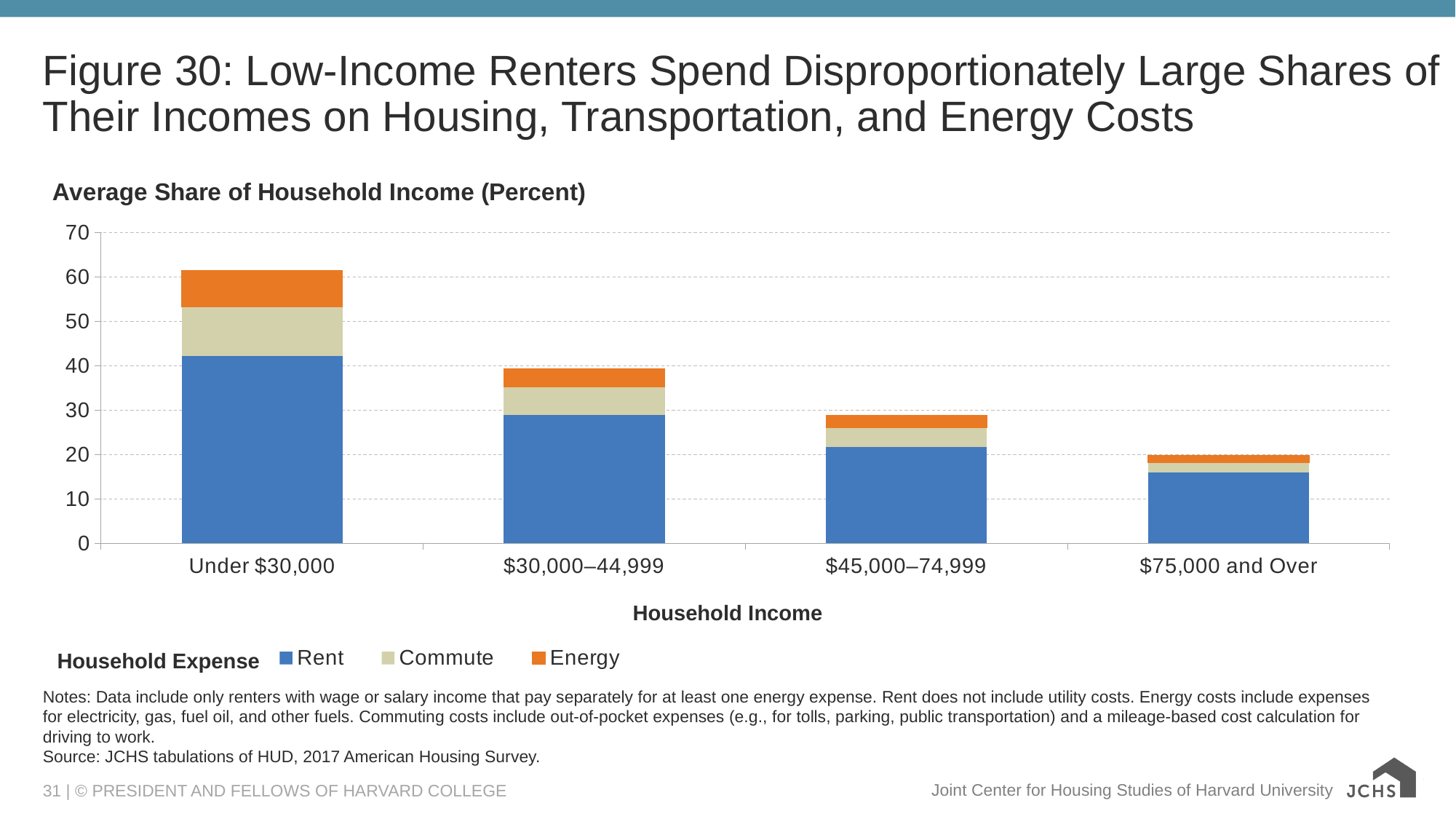
Which has a larger total share: Under $30,000 or $30,000–44,999? Under $30,000 Do the total bar heights rise or fall as household income increases along the x axis? Fall What are the three household expense categories listed in the legend? Rent, Commute, Energy How many household income categories are shown on the x axis? 4 What kind of chart is shown on the slide? Stacked bar chart Which household income category has the lowest total average share of income? $75,000 and Over Is the total value for $75,000 and Over greater or less than 30? less Which household income category has the highest total average share of income? Under $30,000 Is the total value for Under $30,000 greater or less than 50? greater Is the Rent value for $75,000 and Over greater or less than 20? less How many series does the legend list? 3